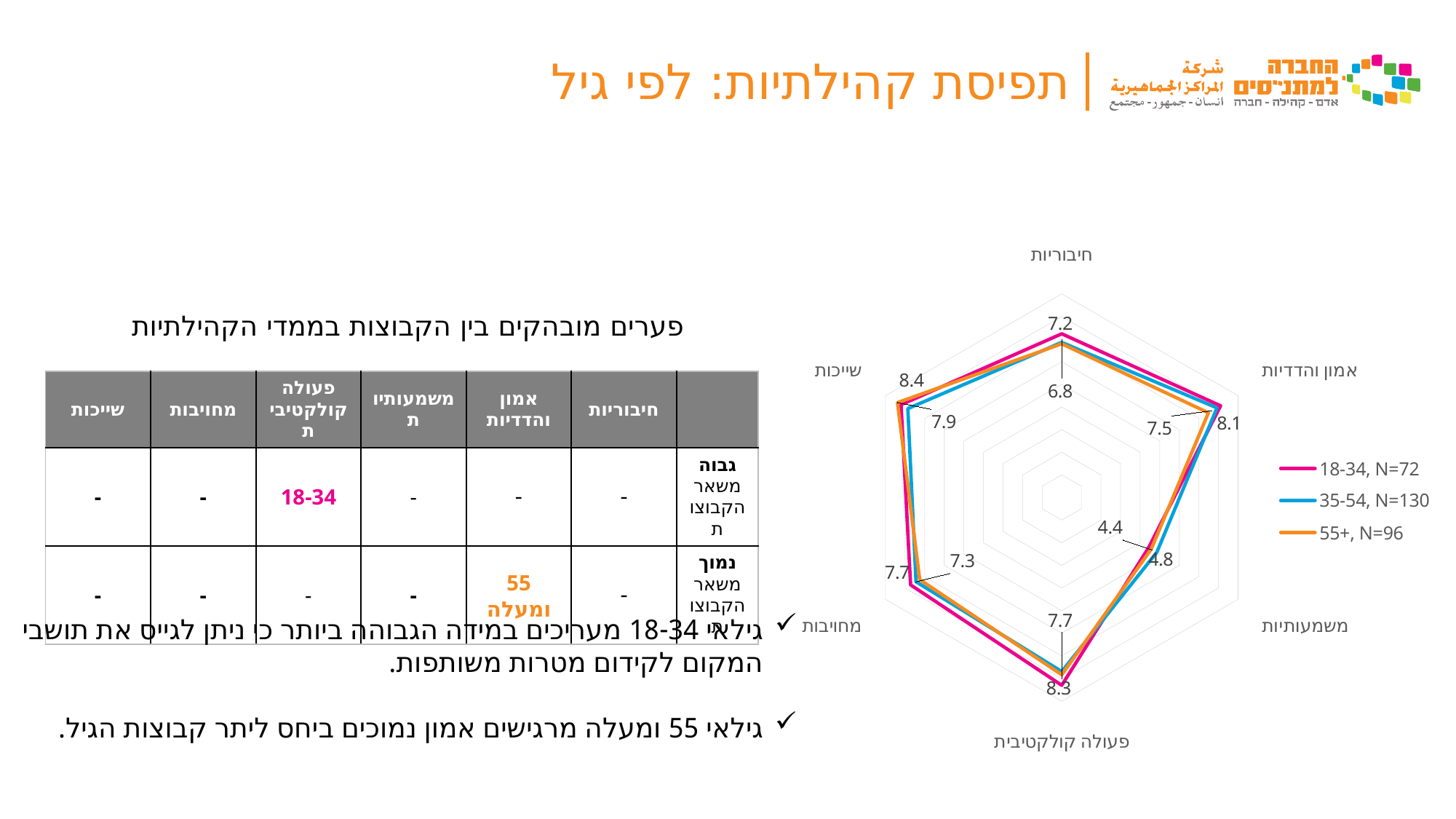
How many axes (categories) does the radar chart have? 6 What is the sample size (N) for the 35-54 age group in the radar chart legend? 130 What is the difference between the 18-34 group and the 55+ group on the אמון והדדיות (trust and reciprocity) axis? 0.6 Which age group has the lowest value on the אמון והדדיות (trust and reciprocity) axis? 55+ Which axis of the radar chart has the lowest values across all groups? משמעותיות What is the sample size (N) for the 18-34 age group in the radar chart legend? 72 What is the value for the 55+ group on the אמון והדדיות (trust and reciprocity) axis? 7.5 What is the value for the 18-34 group on the אמון והדדיות (trust and reciprocity) axis? 8.1 What is the highest value shown on the פעולה קולקטיבית (collective action) axis? 8.3 What kind of chart is shown on the slide? Radar chart How many series does the legend of the radar chart list? 3 Which age group has the highest value on the פעולה קולקטיבית (collective action) axis? 18-34